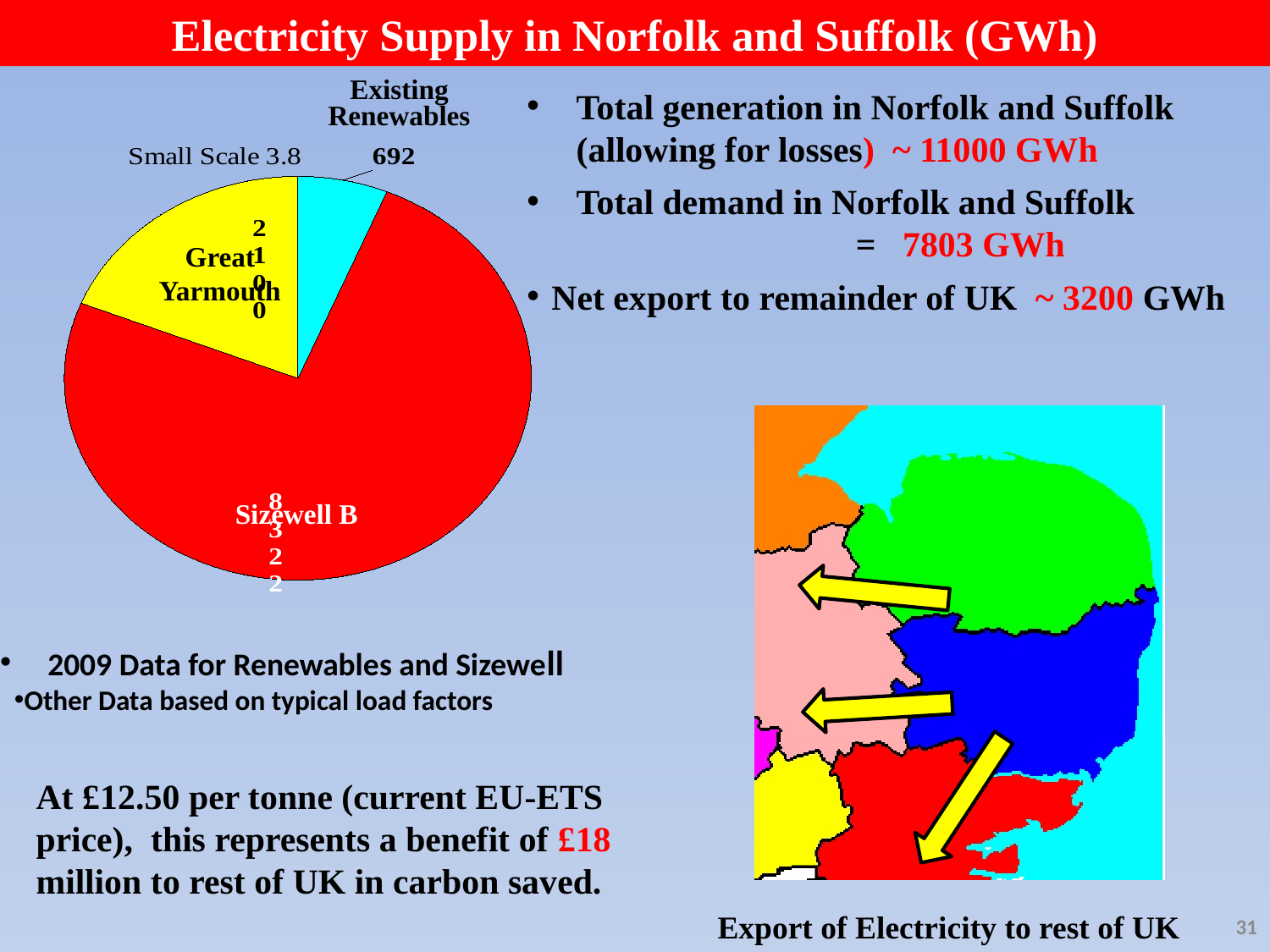
Which category has the smallest slice of the pie chart? Small Scale Which slice is larger in the pie chart, Great Yarmouth or Existing Renewables? Great Yarmouth What value is shown for Small Scale in the pie chart? 3.8 What unit is given in the slide title for the electricity supply figures? GWh What kind of chart is shown on the left of the slide? pie chart What colour is the Sizewell B slice in the pie chart? red How many categories are labelled in the pie chart? 4 Which slice is larger in the pie chart, Sizewell B or Great Yarmouth? Sizewell B What value is shown for Existing Renewables in the pie chart? 692 Which category has the largest slice of the pie chart? Sizewell B